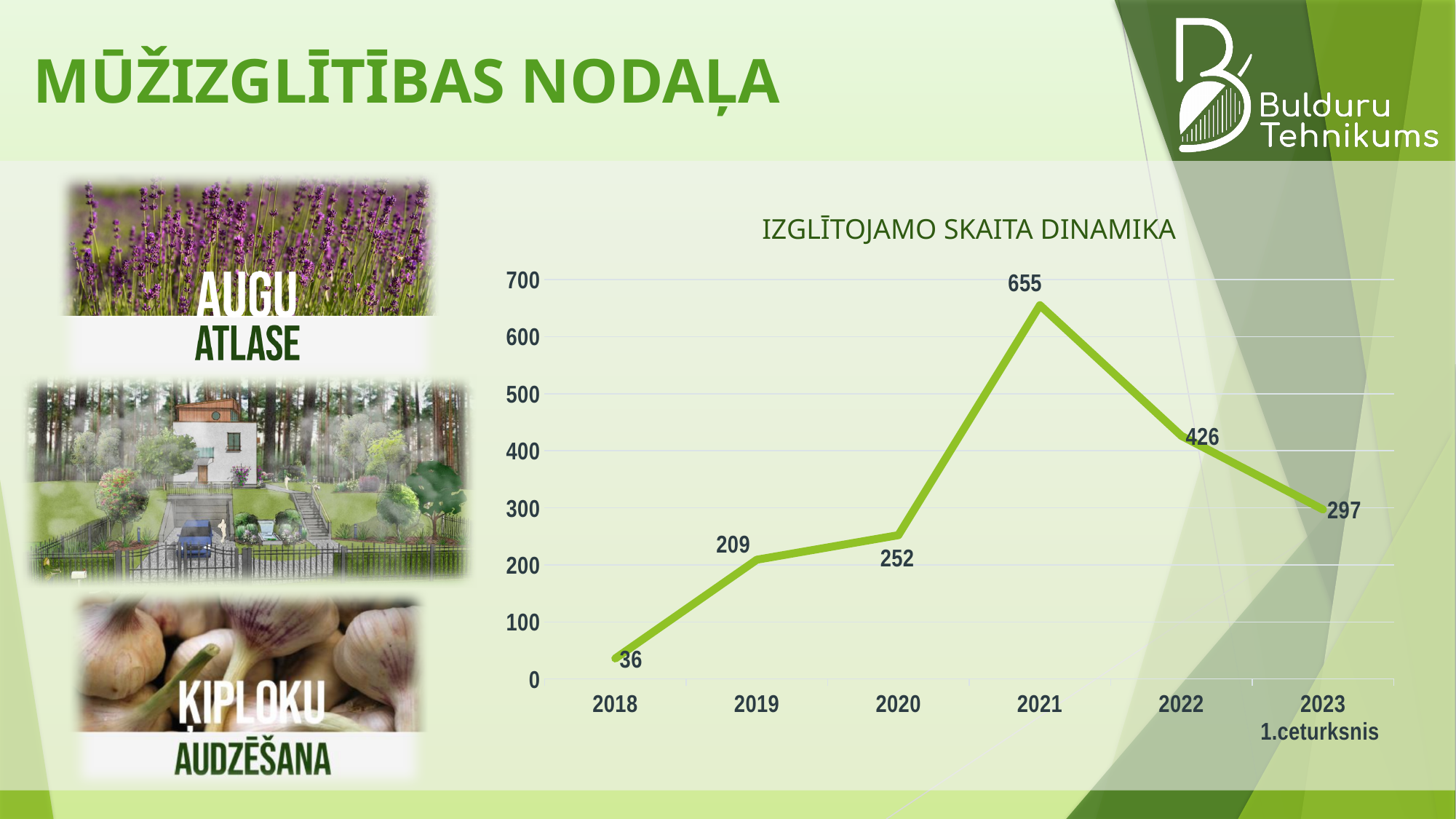
Which year has the highest value in the chart? 2021 Which is larger, the value for 2022 or the value for 2023 1.ceturksnis? 2022 What is the value for 2023 1.ceturksnis in the chart? 297 What is the value for 2021 in the chart? 655 What is the difference between the values for 2021 and 2022? 229 Which year has the lowest value in the chart? 2018 How many data points are plotted in the chart? 6 What is the difference between the values for 2020 and 2019? 43 Do the values rise or fall from 2018 to 2021? rise What is the title of the chart? IZGLĪTOJAMO SKAITA DINAMIKA What kind of chart is shown on the slide? line chart What is the value for 2018 in the chart? 36